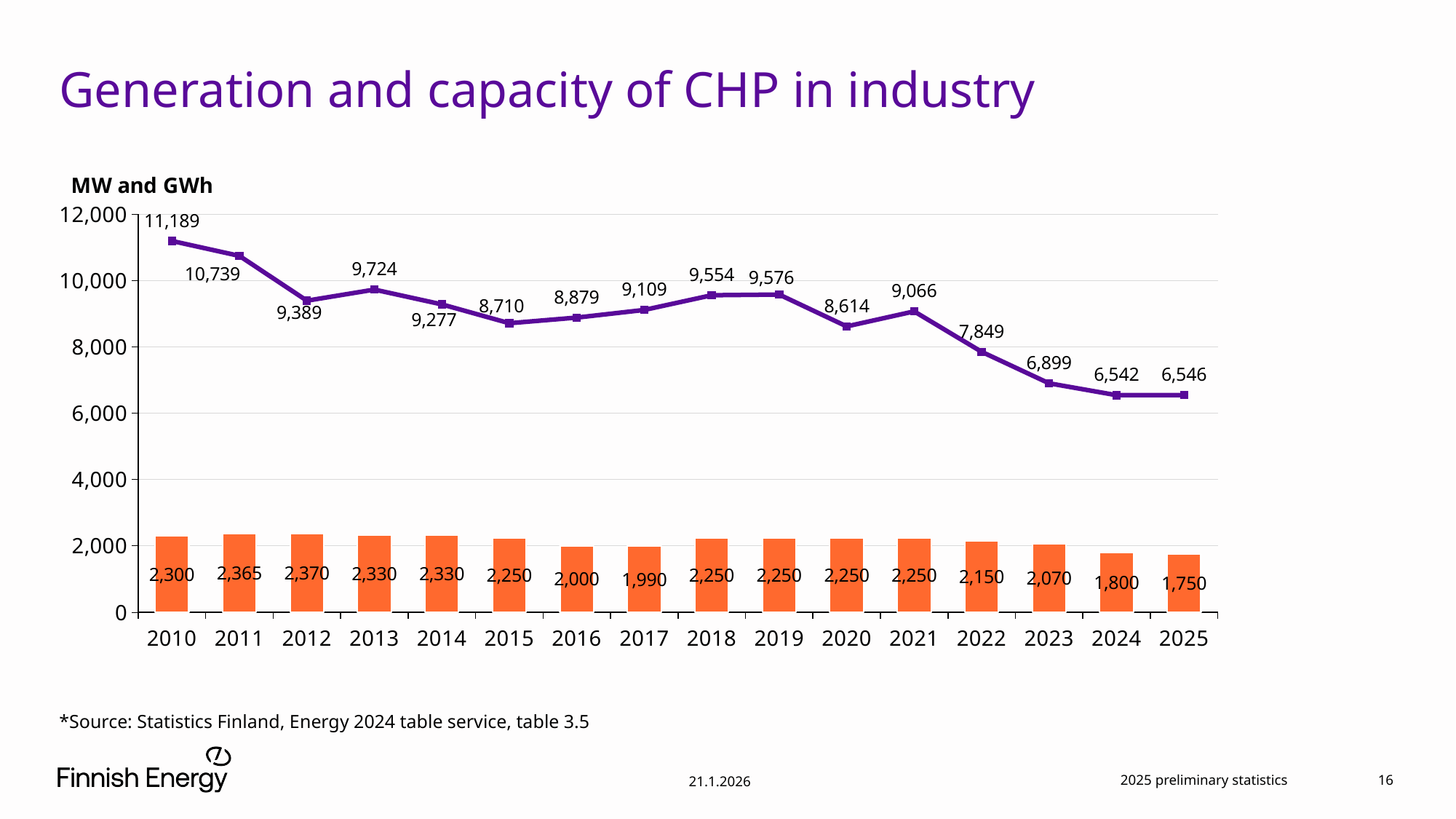
How many years are shown on the x axis? 16 What is the difference between the line values for 2010 and 2025? 4,643 What is the value of the line series for 2025? 6,546 What is the difference between the bar values for 2012 and 2025? 620 Which year has the highest value on the line series? 2010 What is the value of the line series for 2010? 11,189 Which is larger, the line value for 2013 or the line value for 2014? 2013 What is the title of the chart? Generation and capacity of CHP in industry Which year has the lowest value on the line series? 2024 What kind of chart is this? Combined bar and line chart Which year has the lowest bar value? 2025 What is the value of the bar for 2016? 2,000